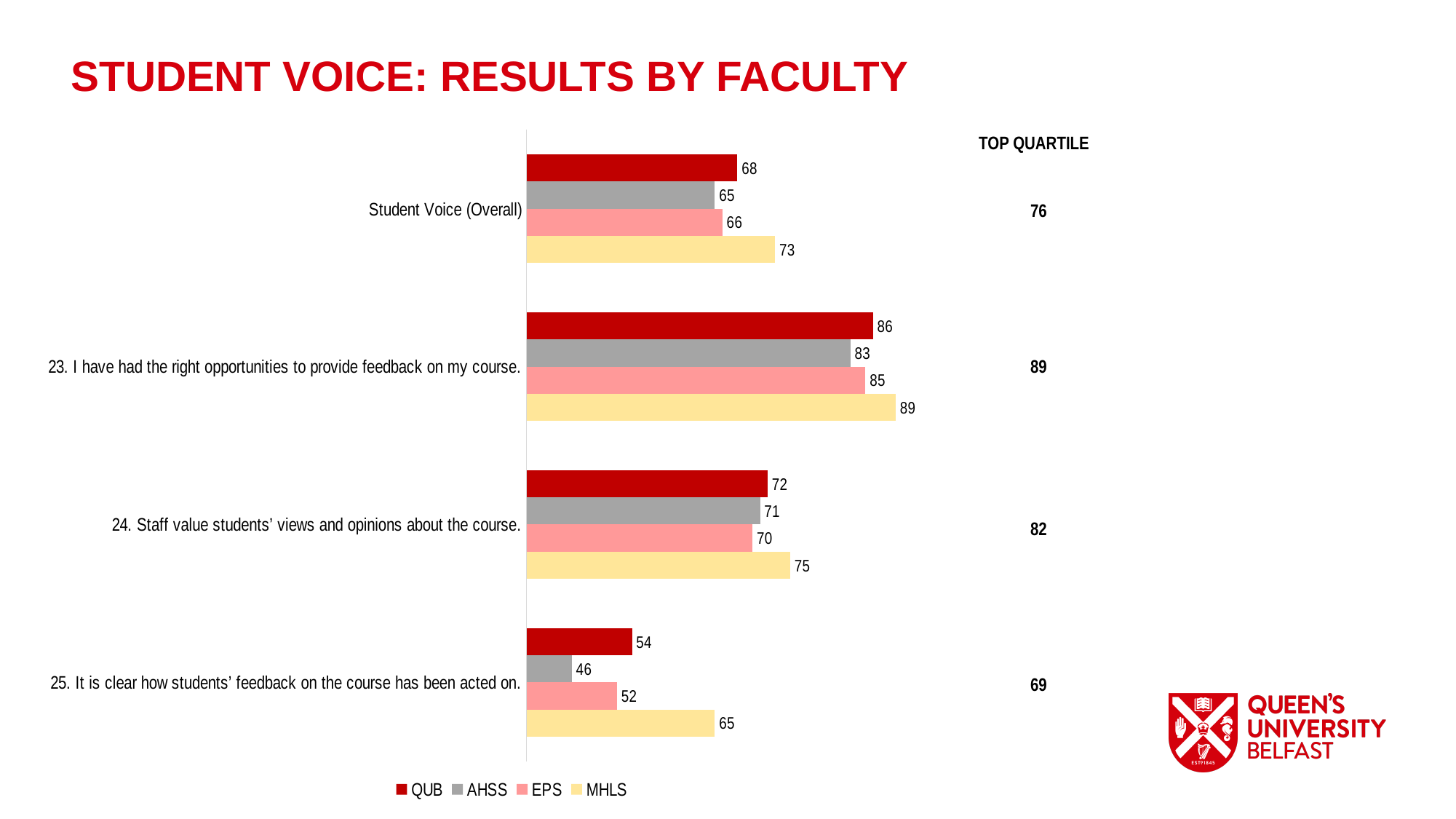
What is the QUB value for question 23, 'I have had the right opportunities to provide feedback on my course'? 86 How many series does the legend list? 4 What kind of chart is shown on the slide? Bar chart What is the AHSS value for question 25, 'It is clear how students' feedback on the course has been acted on'? 46 Which is larger for Student Voice (Overall): the QUB value or the EPS value? QUB What is the difference between the MHLS and AHSS values for question 25? 19 Which faculty has the lowest value for question 23? AHSS What is the EPS value for question 24, 'Staff value students' views and opinions about the course'? 70 How many question categories are shown on the chart? 4 Which faculty has the highest value for question 25? MHLS What is the MHLS value for Student Voice (Overall)? 73 What is the Top Quartile value shown for question 24? 82